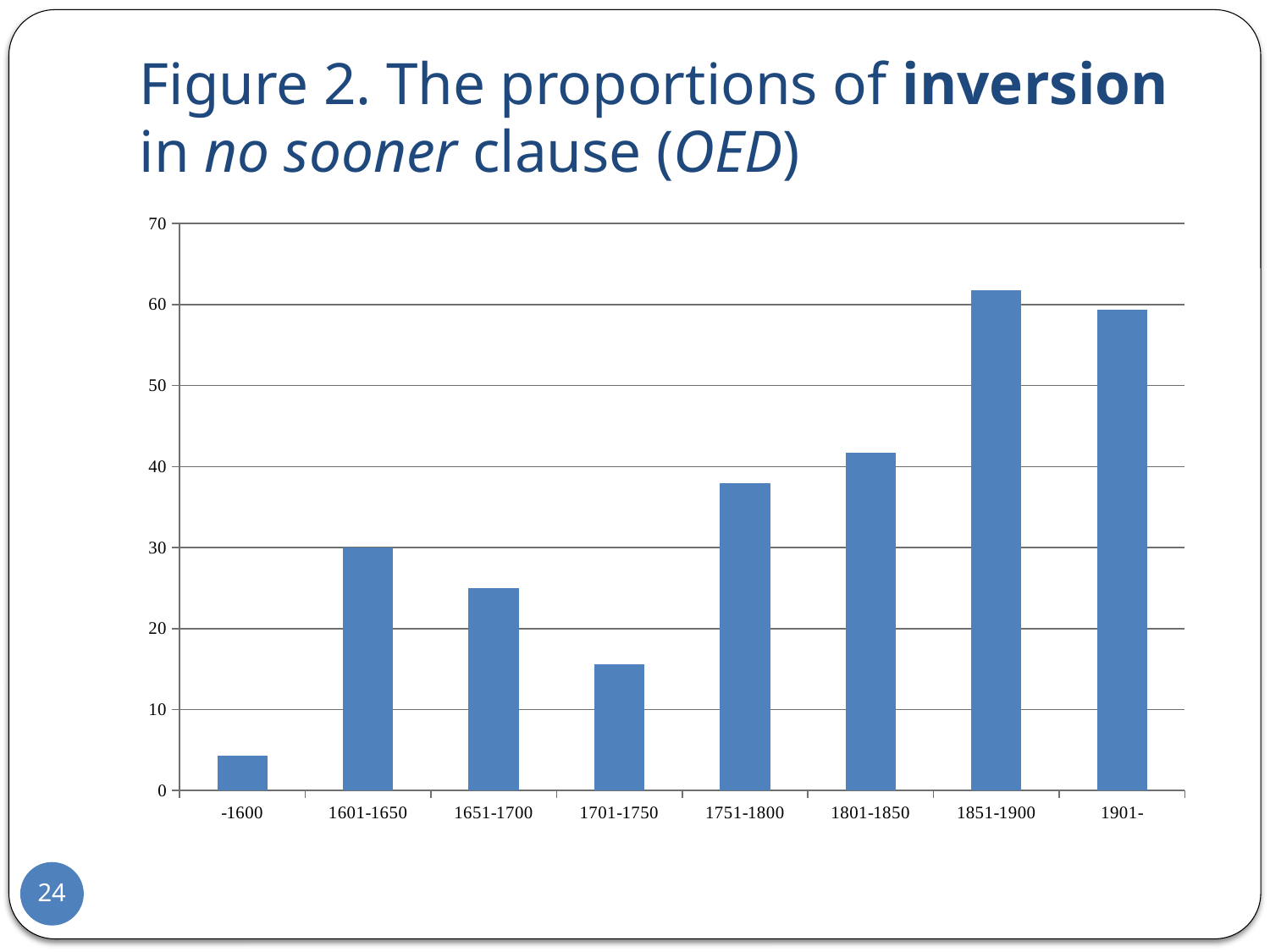
How many period categories are shown on the x axis? 8 Overall, do the values rise or fall from -1600 to 1901-? rise Which period has the lowest proportion of inversion? -1600 Is the value for 1701-1750 greater or less than 20? less What kind of chart is shown on the slide? bar chart Is the value for 1801-1850 greater or less than 40? greater Is the value for -1600 greater or less than 10? less Which is larger, the value for 1601-1650 or the value for 1651-1700? 1601-1650 Which period has the highest proportion of inversion? 1851-1900 What is the figure number given in the slide title? Figure 2